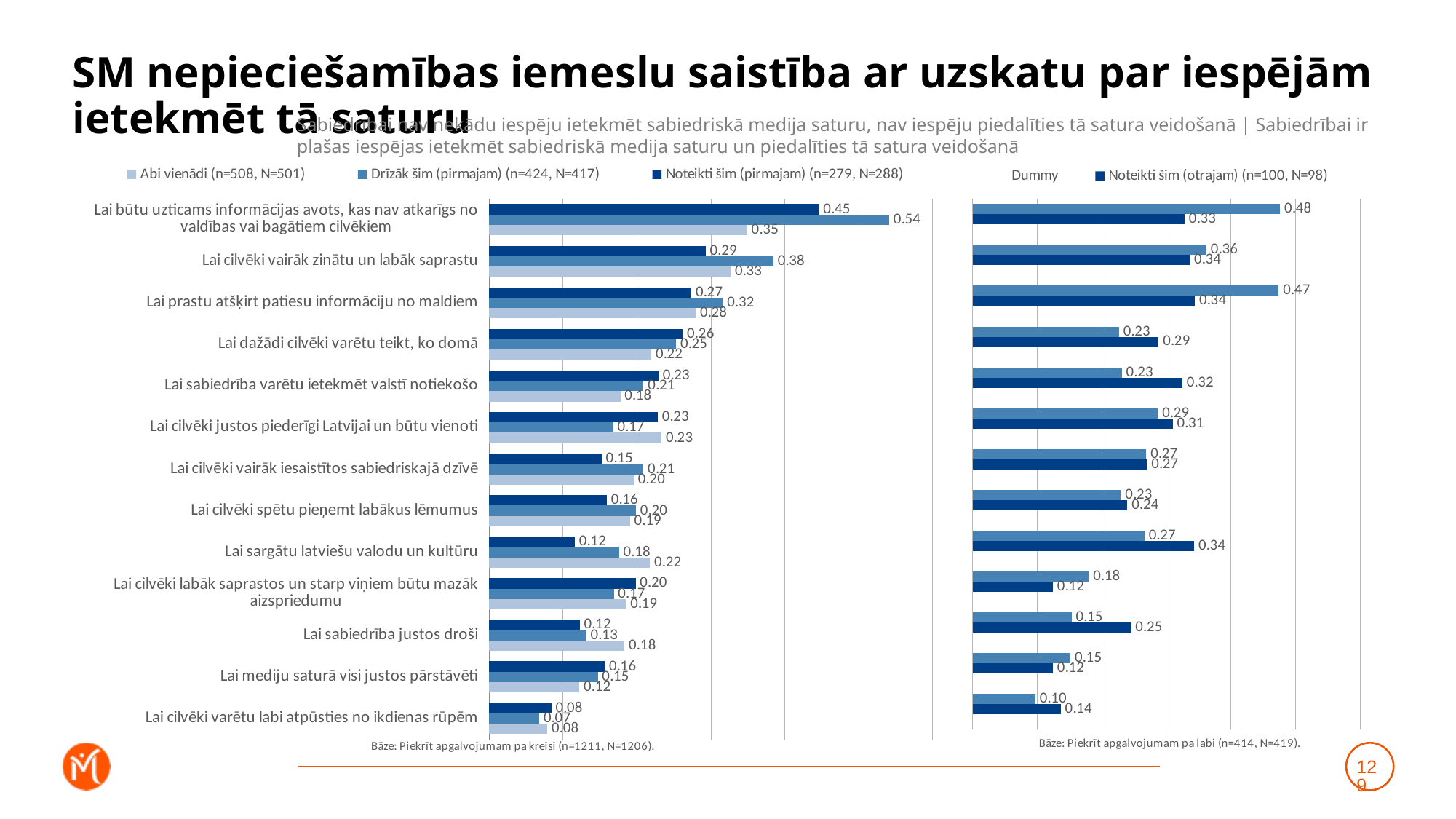
What is the base (Bāze) stated under the left chart? Piekrīt apgalvojumam pa kreisi (n=1211, N=1206) In the left chart, what is the value of 'Abi vienādi' for 'Lai sargātu latviešu valodu un kultūru'? 0.22 In the left chart, what is the difference between the 'Drīzāk šim (pirmajam)' and 'Abi vienādi' values for 'Lai cilvēki vairāk zinātu un labāk saprastu'? 0.05 How many series does the legend of the left chart list? 3 What type of chart is used on this slide? Bar chart In the left chart, what is the value of 'Drīzāk šim (pirmajam)' for 'Lai būtu uzticams informācijas avots, kas nav atkarīgs no valdības vai bagātiem cilvēkiem'? 0.54 In the left chart, which category has the highest value for 'Noteikti šim (pirmajam)'? Lai būtu uzticams informācijas avots, kas nav atkarīgs no valdības vai bagātiem cilvēkiem In the right chart, what is the value of 'Noteikti šim (otrajam)' for 'Lai sabiedrība justos droši'? 0.25 In the left chart, which category has the lowest value for 'Drīzāk šim (pirmajam)'? Lai cilvēki varētu labi atpūsties no ikdienas rūpēm How many categories are listed on the left chart? 13 In the right chart, which is larger for 'Lai sabiedrība varētu ietekmēt valstī notiekošo': the 'Noteikti šim (otrajam)' value or the other series' value? Noteikti šim (otrajam) In the left chart, what is the value of 'Noteikti šim (pirmajam)' for 'Lai cilvēki vairāk zinātu un labāk saprastu'? 0.29